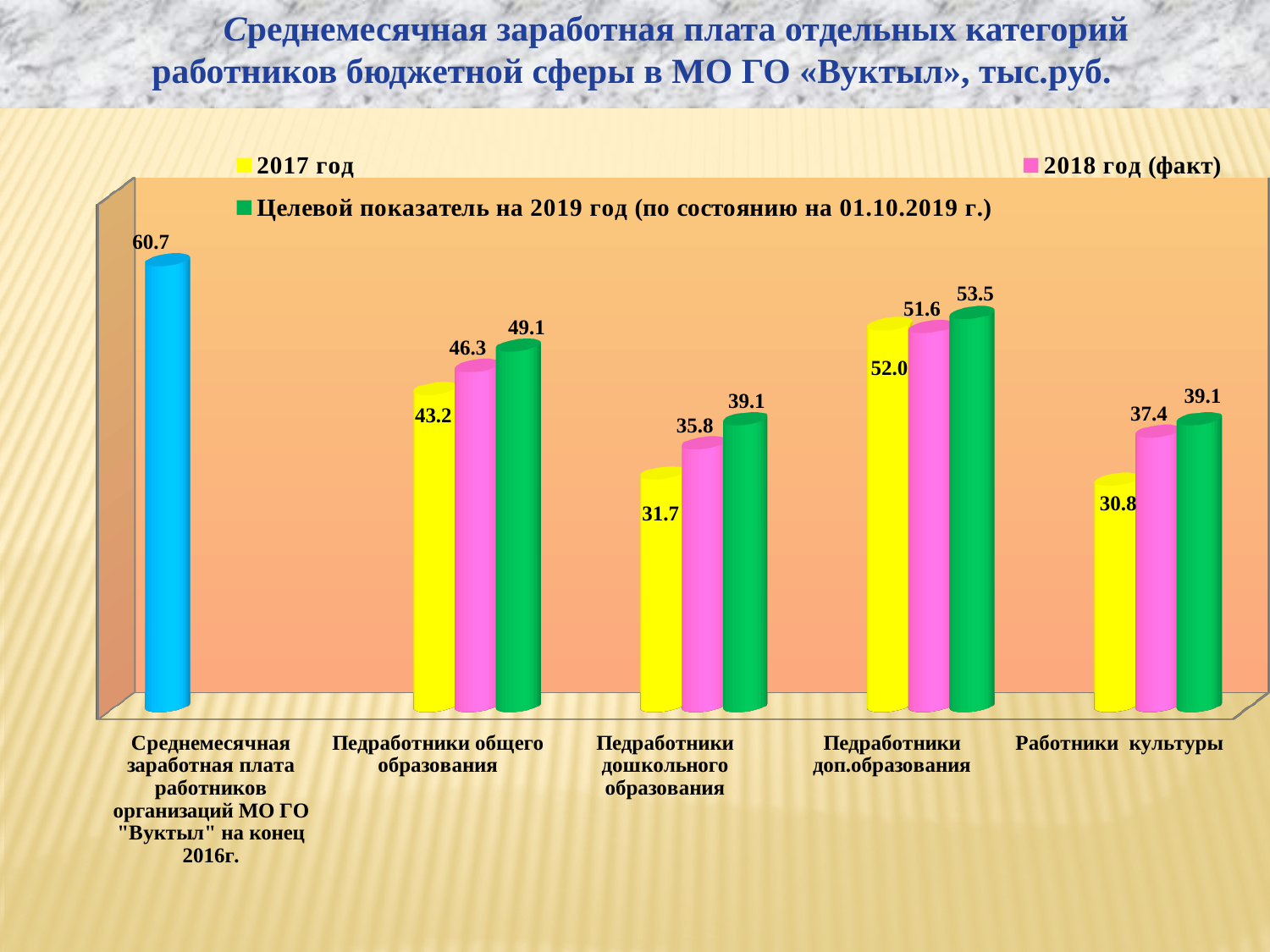
How many series does the legend list? 3 What is the value shown for Среднемесячная заработная плата работников организаций МО ГО "Вуктыл" на конец 2016г.? 60.7 For Педработники доп.образования, which is larger: the 2017 год value or the 2018 год (факт) value? 2017 год What is the 2017 год value for Педработники общего образования? 43.2 What is the Целевой показатель на 2019 год value for Работники культуры? 39.1 How many categories are shown on the x axis? 5 Which category has the lowest 2017 год value? Работники культуры What kind of chart is shown on the slide? Bar chart Among the categories with three bars, which has the highest Целевой показатель на 2019 год value? Педработники доп.образования What is the 2018 год (факт) value for Педработники дошкольного образования? 35.8 What is the difference between the 2019 target and the 2017 год value for Работники культуры? 8.3 What is the difference between the 2018 год (факт) and 2017 год values for Педработники общего образования? 3.1